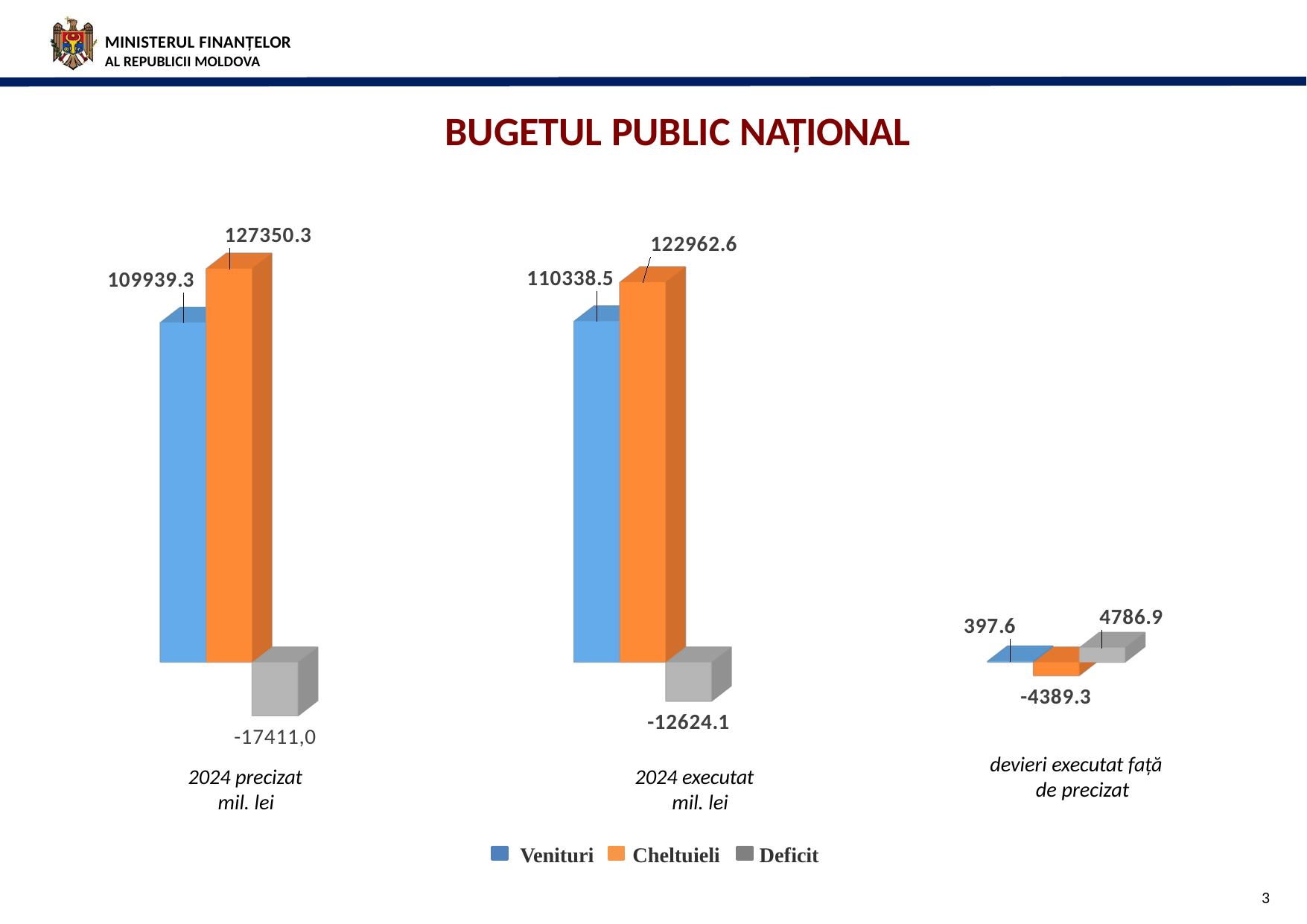
Is Cheltuieli for 2024 precizat larger or smaller than Cheltuieli for 2024 executat? larger What is the difference between Cheltuieli and Venituri for 2024 precizat? 17411.0 What is the Venituri value in the 'devieri executat față de precizat' group? 397.6 What is the value of Venituri for 2024 precizat? 109939.3 Which series has the highest value in the 2024 precizat group? Cheltuieli What is the Deficit value shown for 2024 precizat? -17411,0 How many series does the legend list? 3 What is the Deficit value shown for 2024 executat? -12624.1 What kind of chart is shown on the slide? Bar chart Which series has the lowest value in the 2024 executat group? Deficit What is the value of Cheltuieli for 2024 executat? 122962.6 What is the Cheltuieli value in the 'devieri executat față de precizat' group? -4389.3